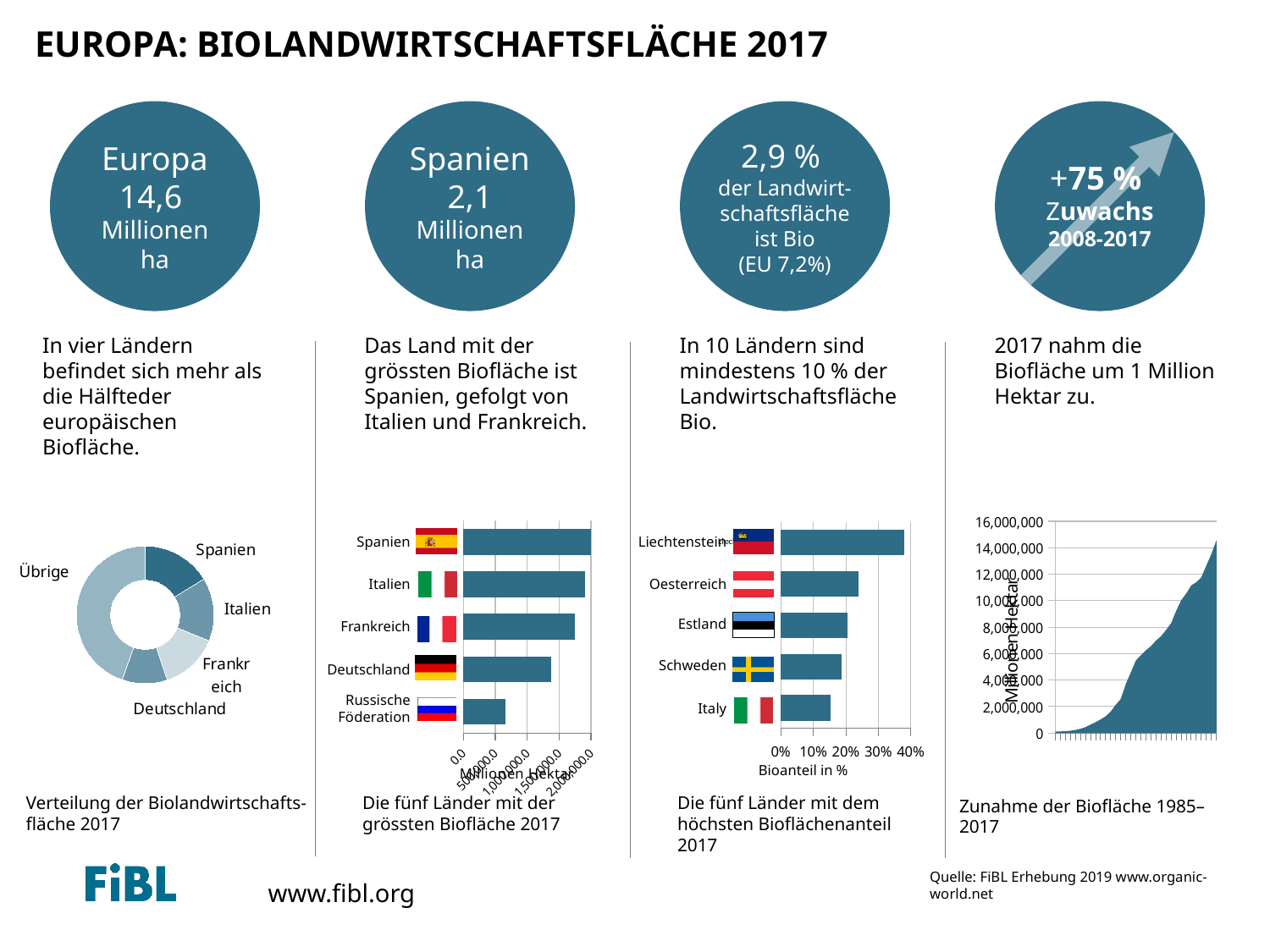
In the chart 'Die fünf Länder mit dem höchsten Bioflächenanteil 2017', which is larger, the value for Oesterreich or the value for Italy? Oesterreich In the chart 'Zunahme der Biofläche 1985–2017', do the values rise or fall over time? Rise In the chart 'Die fünf Länder mit dem höchsten Bioflächenanteil 2017', which country has the highest organic share? Liechtenstein In the chart 'Die fünf Länder mit der grössten Biofläche 2017', which country has the smallest organic area? Russische Föderation In the chart 'Die fünf Länder mit der grössten Biofläche 2017', how many countries are shown? 5 In the chart 'Die fünf Länder mit der grössten Biofläche 2017', is the value for Russische Föderation greater or less than 1,000,000.0? less In the chart 'Die fünf Länder mit der grössten Biofläche 2017', which country has the largest organic area? Spanien What kind of chart is 'Verteilung der Biolandwirtschaftsfläche 2017'? Donut (pie) chart In the chart 'Die fünf Länder mit dem höchsten Bioflächenanteil 2017', is the value for Liechtenstein greater or less than 30%? greater In the chart 'Die fünf Länder mit dem höchsten Bioflächenanteil 2017', which country has the lowest organic share? Italy What is the x-axis label of the chart 'Die fünf Länder mit dem höchsten Bioflächenanteil 2017'? Bioanteil in %